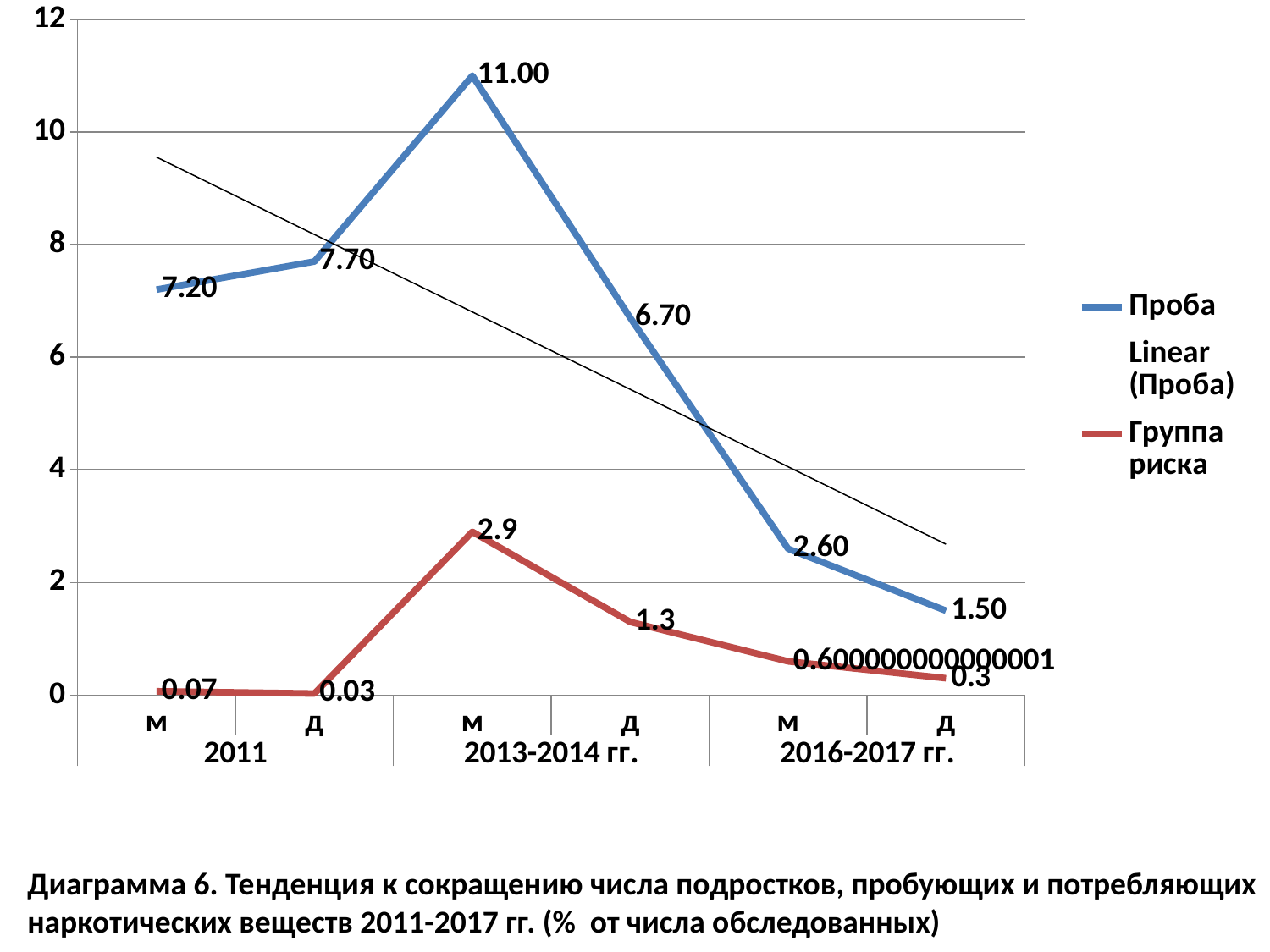
Does the Проба series rise or fall from м in 2013-2014 гг. to д in 2016-2017 гг.? fall What is the value of Группа риска for д in 2013-2014 гг.? 1.3 What type of chart is shown on the slide? line chart Which is larger: the Проба value for д in 2013-2014 гг. or for м in 2016-2017 гг.? д in 2013-2014 гг. What is the value of Проба for м in 2013-2014 гг.? 11.00 How many data points does the Проба series have? 6 What is the value of Проба for д in 2016-2017 гг.? 1.50 At which point does the Группа риска series have its lowest value? д, 2011 What is the value of Группа риска for м in 2011? 0.07 What is the difference between the Проба values for м in 2011 and д in 2011? 0.50 How many entries does the legend list? 3 At which point does the Проба series reach its highest value? м, 2013-2014 гг.